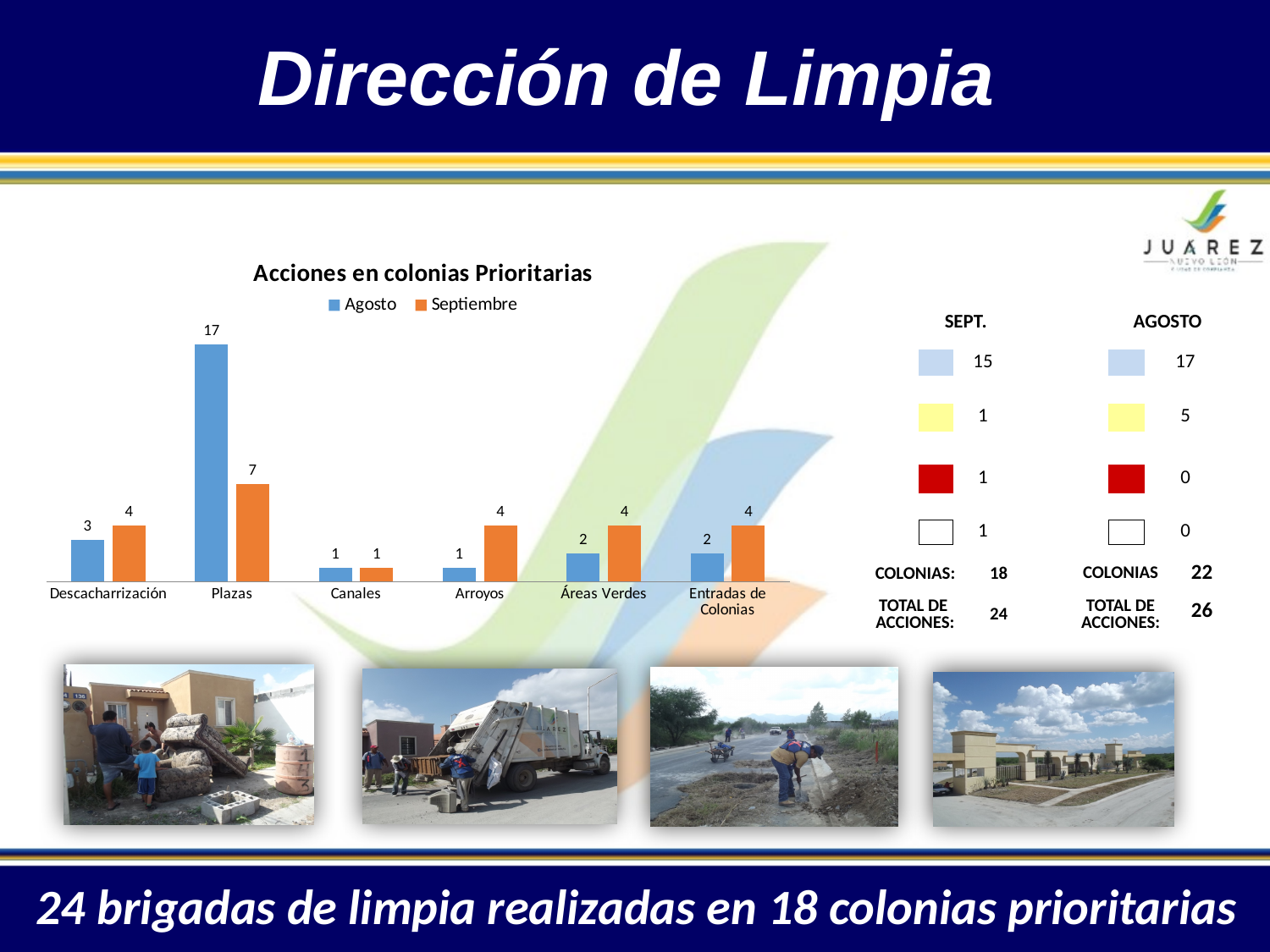
How many categories are shown on the x axis of the chart? 6 Which category has the lowest Septiembre value? Canales Which series is shown in orange in the chart? Septiembre What is the Agosto value for Plazas? 17 What type of chart is shown on the slide? Bar chart For Áreas Verdes, which is larger: the Agosto value or the Septiembre value? Septiembre Which category has the highest Agosto value? Plazas What is the title of the chart? Acciones en colonias Prioritarias How many series does the chart legend list? 2 What is the difference between the Agosto and Septiembre values for Plazas? 10 What is the Septiembre value for Descacharrización? 4 What is the Agosto value for Arroyos? 1